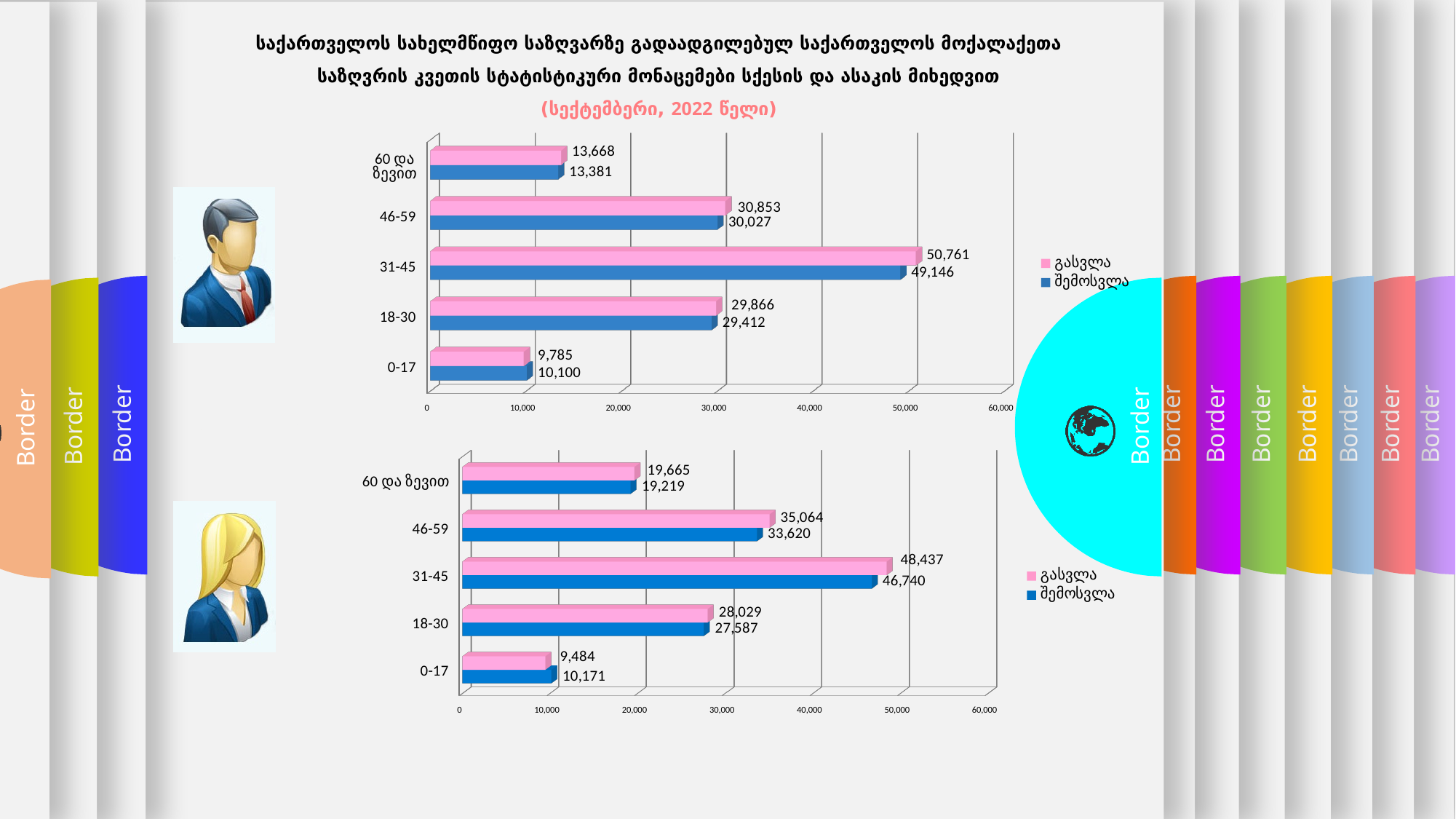
In the top chart, what is the difference between the გასვლა and შემოსვლა values for the 31-45 age group? 1,615 How many age groups are shown in the top chart? 5 In the top chart, which age group has the highest გასვლა value? 31-45 In the bottom chart, which age group has the lowest შემოსვლა value? 0-17 What type of chart is the top chart? Bar chart In the bottom chart, what is the შემოსვლა value for the 60 და ზევით age group? 19,219 In the top chart, what is the გასვლა value for the 31-45 age group? 50,761 In the bottom chart, which is larger for the 0-17 age group: გასვლა or შემოსვლა? შემოსვლა In the top chart, what is the შემოსვლა value for the 0-17 age group? 10,100 How many series does the legend of the bottom chart list? 2 In the bottom chart, what is the difference between the გასვლა and შემოსვლა values for the 46-59 age group? 1,444 In the bottom chart, what is the გასვლა value for the 46-59 age group? 35,064